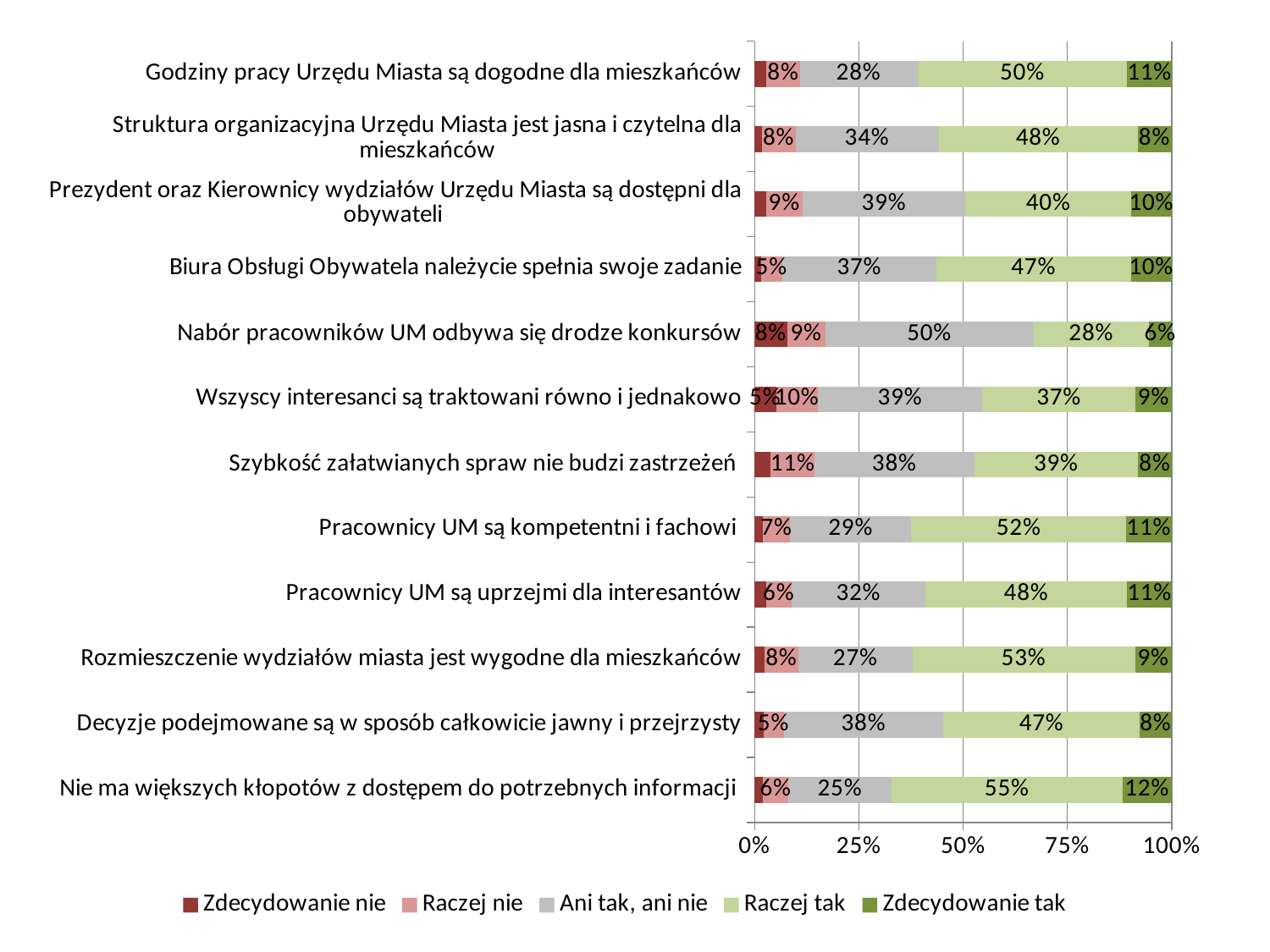
What percentage of respondents answered "Raczej tak" to "Nie ma większych kłopotów z dostępem do potrzebnych informacji"? 55% What is the "Ani tak, ani nie" value for "Nabór pracowników UM odbywa się drodze konkursów"? 50% Which statement has the highest "Raczej tak" share? Nie ma większych kłopotów z dostępem do potrzebnych informacji What type of chart is shown on the slide? Stacked bar chart Which has a larger "Ani tak, ani nie" share: "Struktura organizacyjna Urzędu Miasta jest jasna i czytelna dla mieszkańców" or "Godziny pracy Urzędu Miasta są dogodne dla mieszkańców"? Struktura organizacyjna Urzędu Miasta jest jasna i czytelna dla mieszkańców Which statement has the highest "Zdecydowanie tak" share? Nie ma większych kłopotów z dostępem do potrzebnych informacji Is the "Raczej tak" value for "Pracownicy UM są kompetentni i fachowi" greater or less than 50%? greater Which statement has the lowest "Raczej tak" share? Nabór pracowników UM odbywa się drodze konkursów How many statements are shown on the chart? 12 For "Godziny pracy Urzędu Miasta są dogodne dla mieszkańców", what is the difference between the "Raczej tak" and "Zdecydowanie tak" values? 39 percentage points How many response categories does the legend list? 5 What is the "Zdecydowanie tak" value for "Prezydent oraz Kierownicy wydziałów Urzędu Miasta są dostępni dla obywateli"? 10%